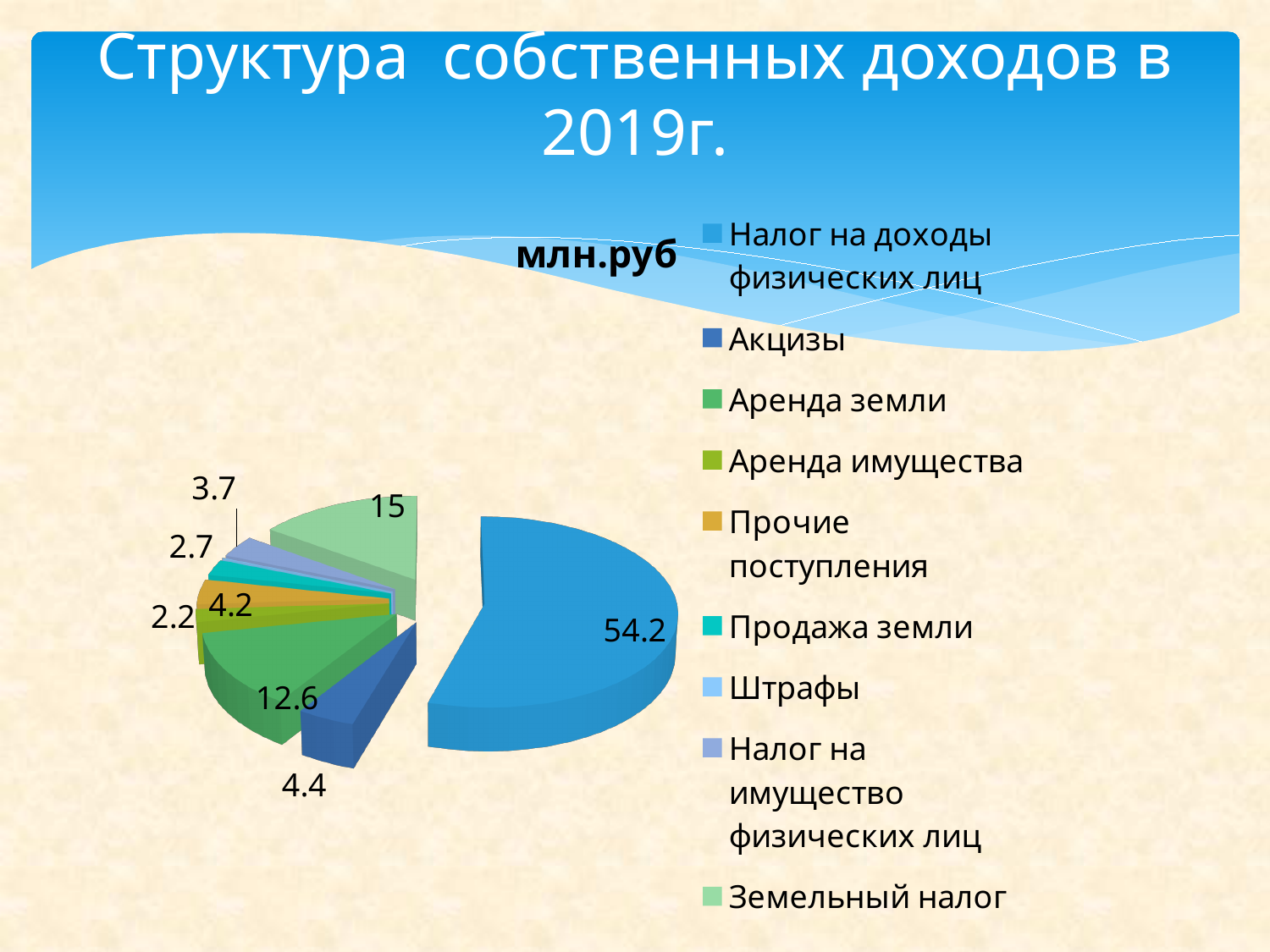
What is the difference between the values for Налог на доходы физических лиц and Земельный налог? 39.2 What is the value for Прочие поступления? 4.2 What is the value for Налог на доходы физических лиц? 54.2 What is the title shown above the pie chart? млн.руб Which is larger, Аренда земли or Земельный налог? Земельный налог What is the value for Аренда земли? 12.6 What is the value for Земельный налог? 15 What type of chart is shown on the slide? pie chart Which category has the largest slice of the pie? Налог на доходы физических лиц What is the value for Акцизы? 4.4 How many entries does the chart legend list? 9 What is the value for Аренда имущества? 2.2